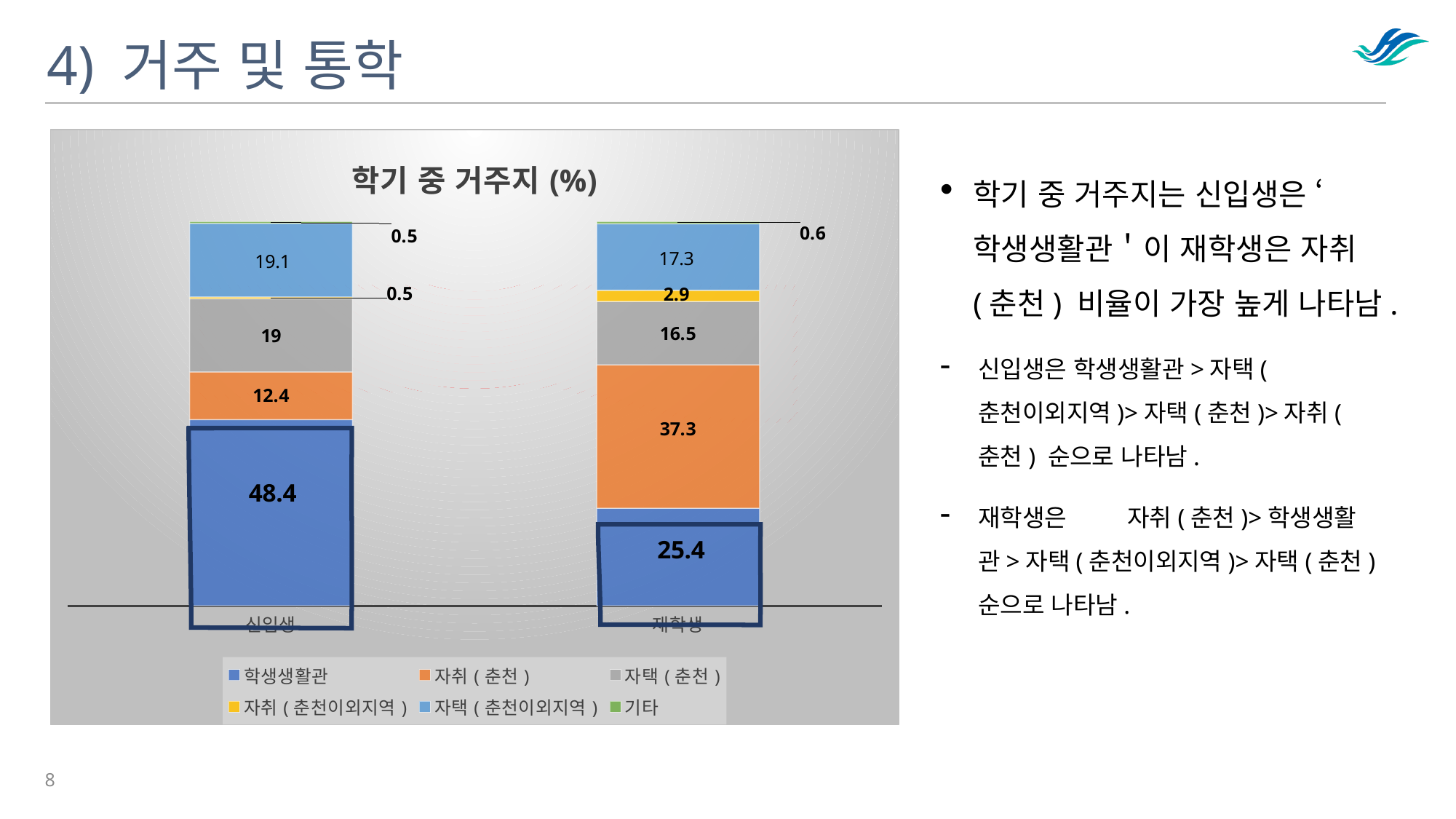
What is the difference between the 학생생활관 values for 신입생 and 재학생? 23 What is the value for 자취 ( 춘천이외지역 ) in the 재학생 bar? 2.9 What is the value for 학생생활관 in the 신입생 bar? 48.4 How many series does the legend list? 6 Which is larger: 자택 ( 춘천이외지역 ) for 신입생 or for 재학생? 신입생 What is the value for 기타 in the 재학생 bar? 0.6 How many categories are shown on the x axis? 2 What is the value for 자취 ( 춘천 ) in the 재학생 bar? 37.3 Which series has the largest value in the 재학생 bar? 자취 ( 춘천 ) What is the value for 자택 ( 춘천 ) in the 신입생 bar? 19 Which series has the largest value in the 신입생 bar? 학생생활관 What kind of chart is shown on the slide? Stacked bar chart